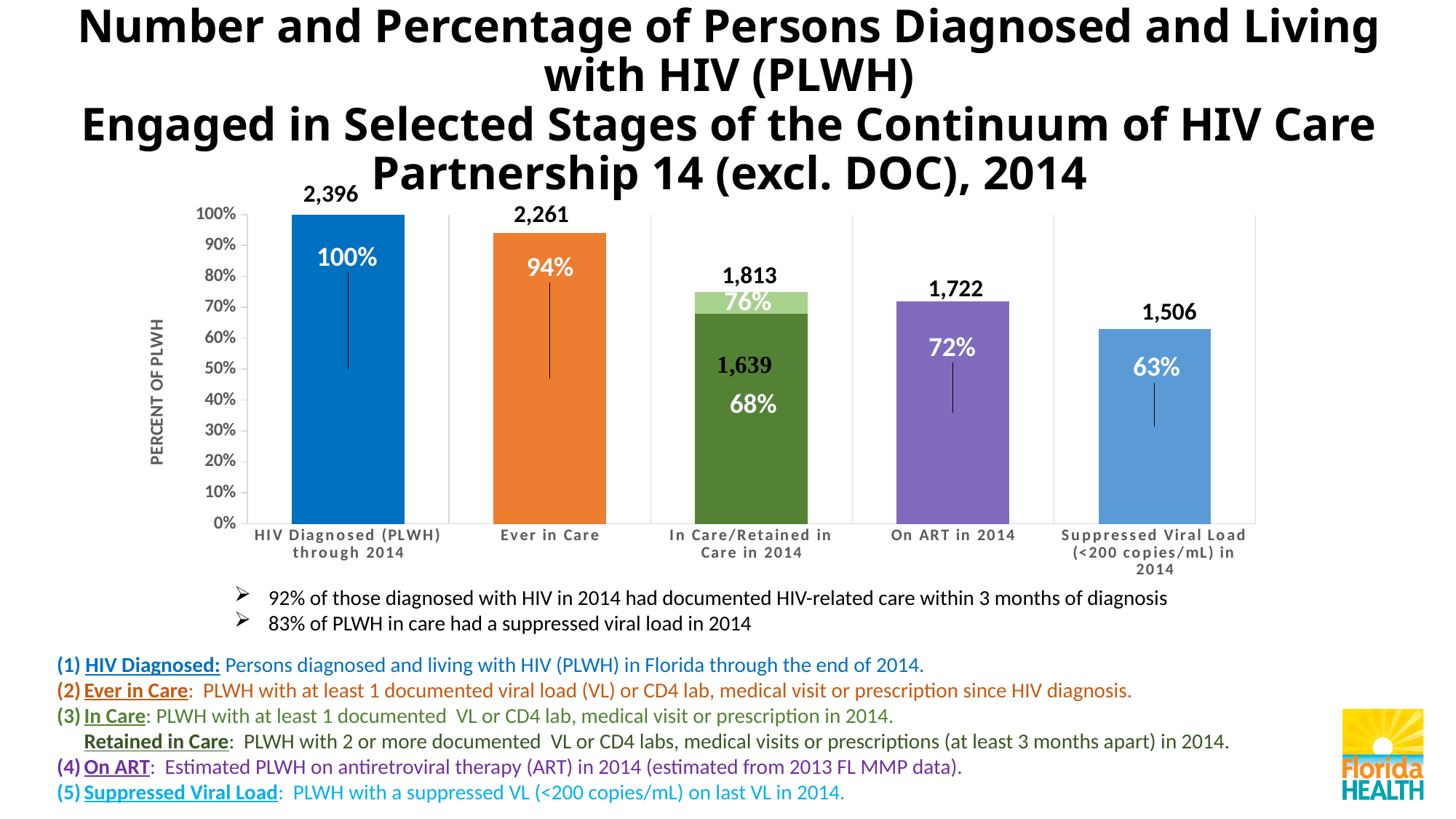
What percentage is shown for the 'On ART in 2014' bar? 72% What number is shown for the darker green 'Retained in Care' portion of the 'In Care/Retained in Care in 2014' bar? 1,639 What percentage is shown for the 'Suppressed Viral Load (<200 copies/mL) in 2014' bar? 63% How many categories are shown on the x axis of the chart? 5 Which category has the highest value in the chart? HIV Diagnosed (PLWH) through 2014 Which category has the lowest value in the chart? Suppressed Viral Load (<200 copies/mL) in 2014 What is the number of persons shown for the 'Ever in Care' bar? 2,261 What is the number of persons shown for 'Suppressed Viral Load (<200 copies/mL) in 2014'? 1,506 What is the difference in number of persons between 'HIV Diagnosed (PLWH) through 2014' and 'Ever in Care'? 135 What kind of chart is shown on the slide? Bar chart Which is larger: the number for 'In Care/Retained in Care in 2014' or the number for 'On ART in 2014'? In Care/Retained in Care in 2014 Do the bar values rise or fall moving from left to right along the x axis? Fall